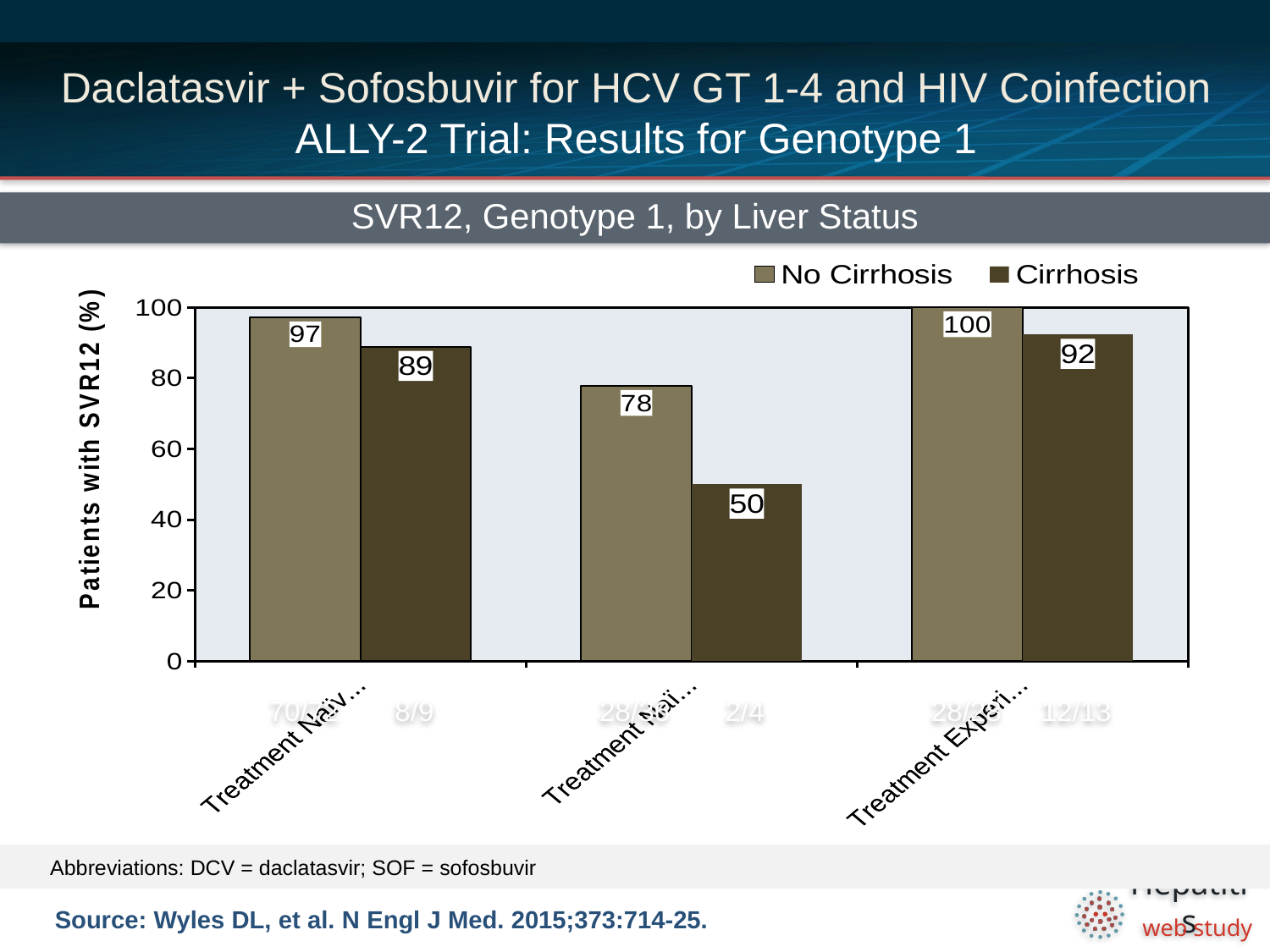
In the rightmost group of bars, which is larger: the No Cirrhosis value or the Cirrhosis value? No Cirrhosis What is the difference between the No Cirrhosis and Cirrhosis values in the middle group of bars? 28 What is the No Cirrhosis value for the rightmost group of bars? 100 What is the label of the y axis? Patients with SVR12 (%) How many series does the chart legend list? 2 What is the Cirrhosis value for the middle group of bars? 50 What is the No Cirrhosis value for the leftmost group of bars? 97 Which series has the lowest value in the chart, and what is it? Cirrhosis, 50 What is the title of the chart? SVR12, Genotype 1, by Liver Status What kind of chart is shown on the slide? bar chart What is the Cirrhosis value for the leftmost group of bars? 89 How many groups of bars are plotted along the x axis? 3